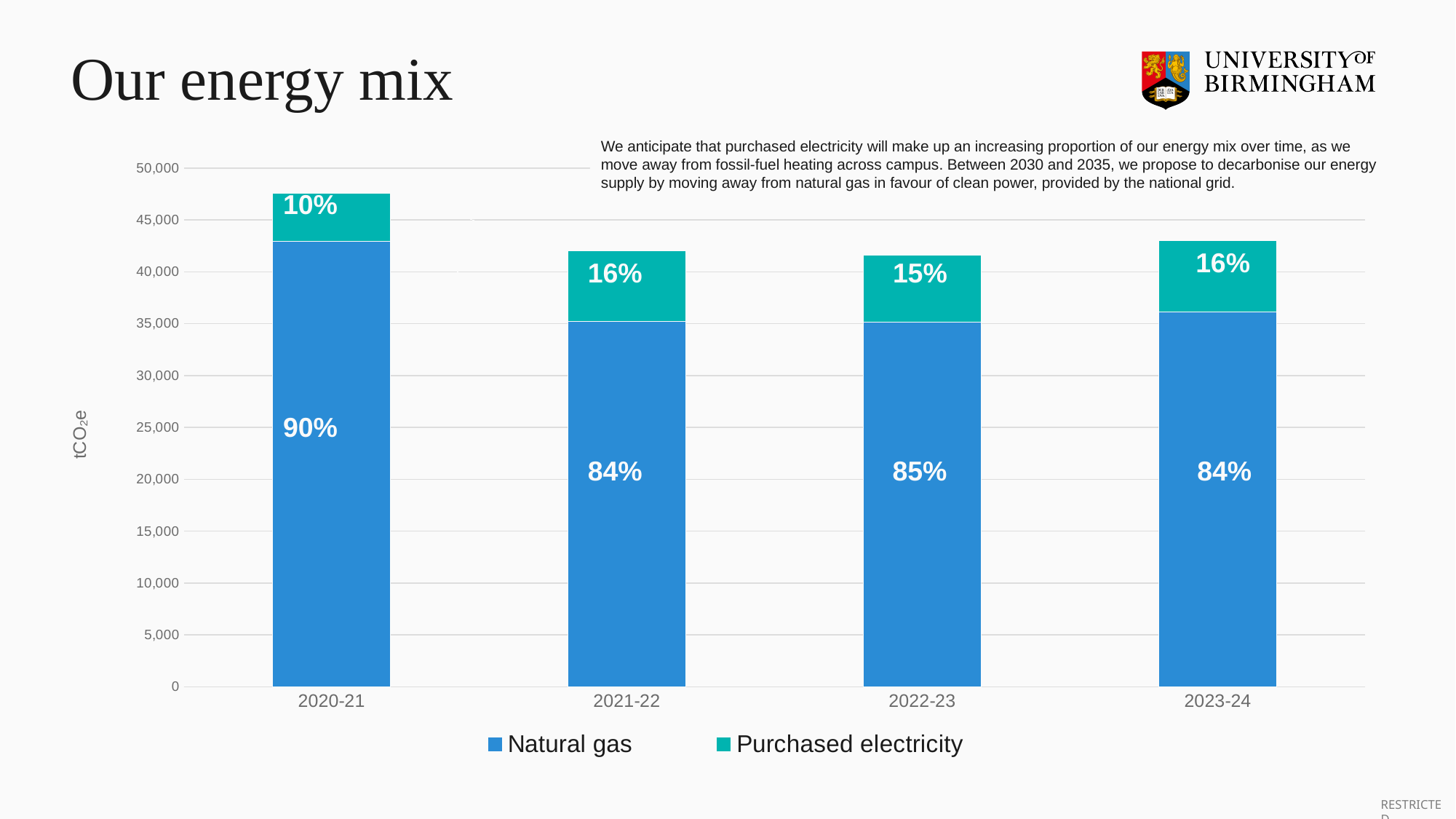
What kind of chart is shown? Stacked bar chart What percentage of the 2023-24 bar is purchased electricity? 16% What percentage of the 2020-21 bar is natural gas? 90% How many series does the legend list? 2 Is the total for 2021-22 greater or less than 45,000? less Is the total for 2020-21 greater or less than 45,000? greater Is the natural gas value for 2023-24 greater or less than 35,000? greater What percentage of the 2022-23 bar is natural gas? 85% How many years are shown on the x axis? 4 What is the label on the y axis? tCO2e Which year has the tallest total bar? 2020-21 Does the purchased electricity share rise or fall from 2020-21 to 2023-24? Rise